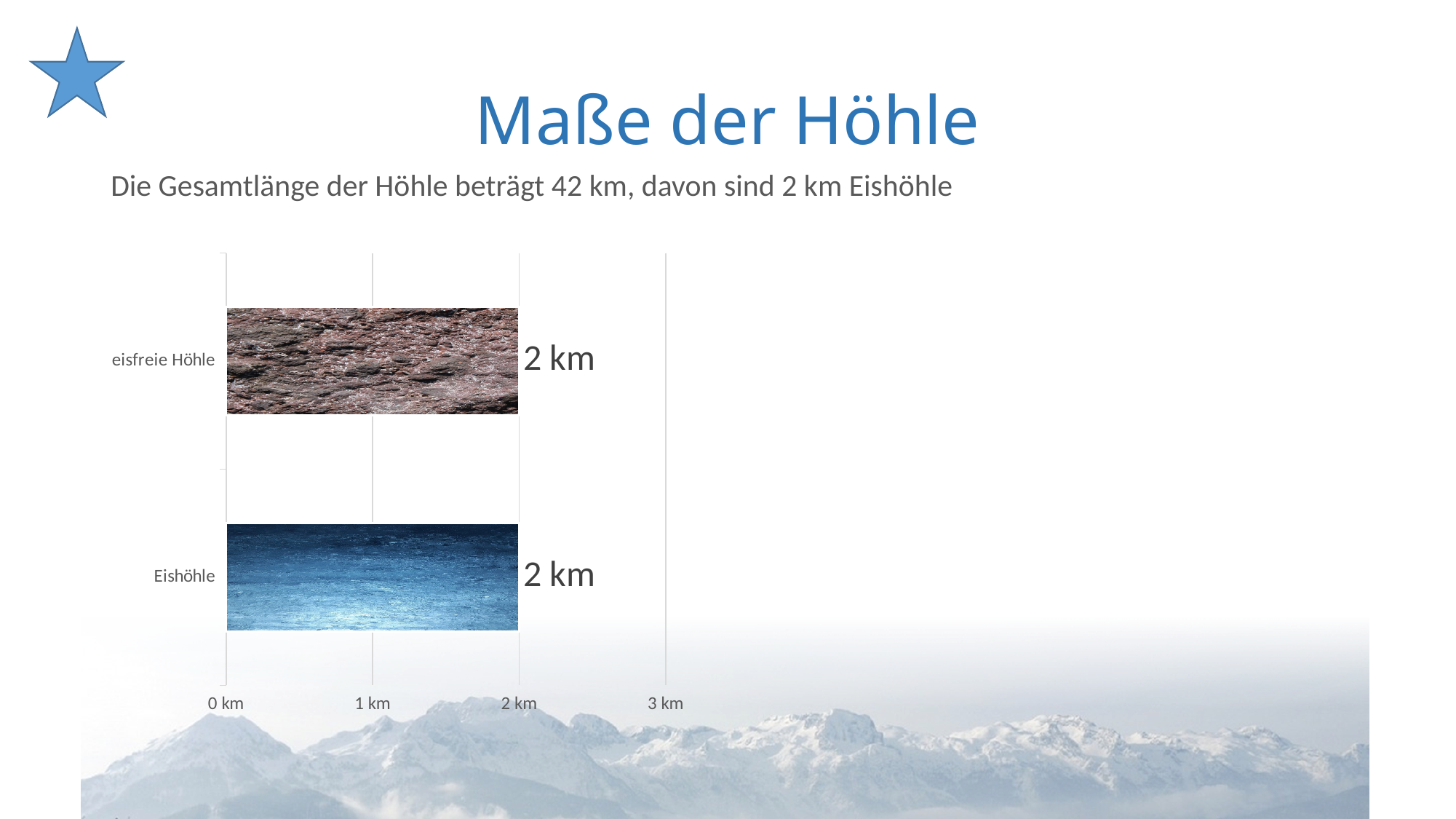
Is the value for eisfreie Höhle greater or less than 3 km? less Is the value for Eishöhle greater or less than 1 km? greater What is the difference between the values for eisfreie Höhle and Eishöhle? 0 km Which category label appears at the top of the chart? eisfreie Höhle What kind of chart is shown on the slide? bar chart What is the highest tick label shown on the horizontal axis? 3 km What is the value shown for Eishöhle? 2 km What is the value shown for eisfreie Höhle? 2 km How many categories are plotted in the chart? 2